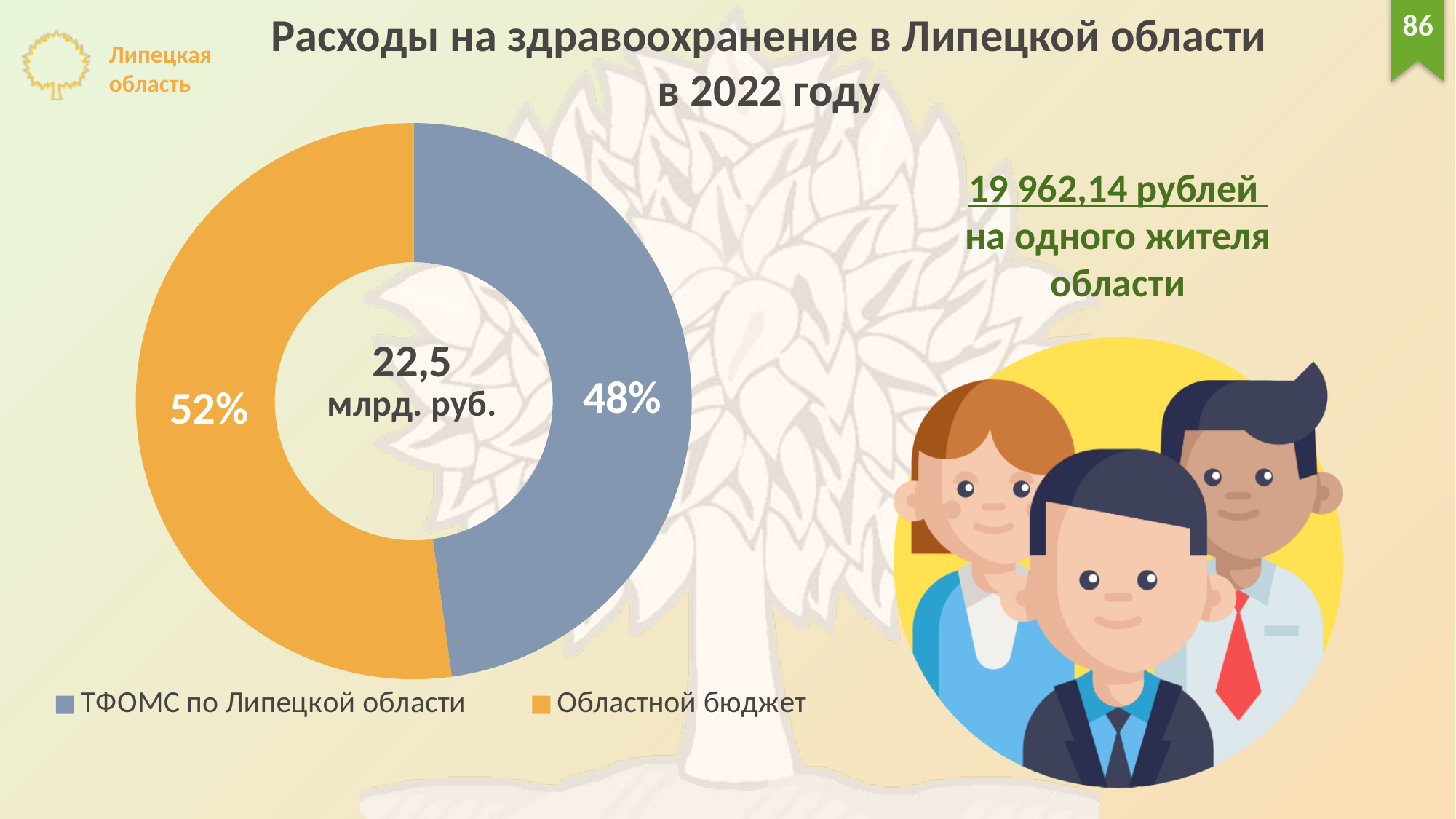
Which is larger: the share of ТФОМС по Липецкой области or the share of Областной бюджет? Областной бюджет What share of healthcare expenditure comes from the Областной бюджет? 52% Which source has the larger share of healthcare expenditure? Областной бюджет Which source has the smaller share of healthcare expenditure? ТФОМС по Липецкой области What total amount is shown in the centre of the chart? 22,5 млрд. руб. What is the title of the chart on the slide? Расходы на здравоохранение в Липецкой области в 2022 году What share of healthcare expenditure comes from ТФОМС по Липецкой области? 48% By how many percentage points does the Областной бюджет share exceed the ТФОМС share? 4 What colour represents Областной бюджет in the chart? Orange How many categories does the chart show? 2 How many entries does the legend list? 2 What kind of chart is shown on the slide? Pie (doughnut) chart